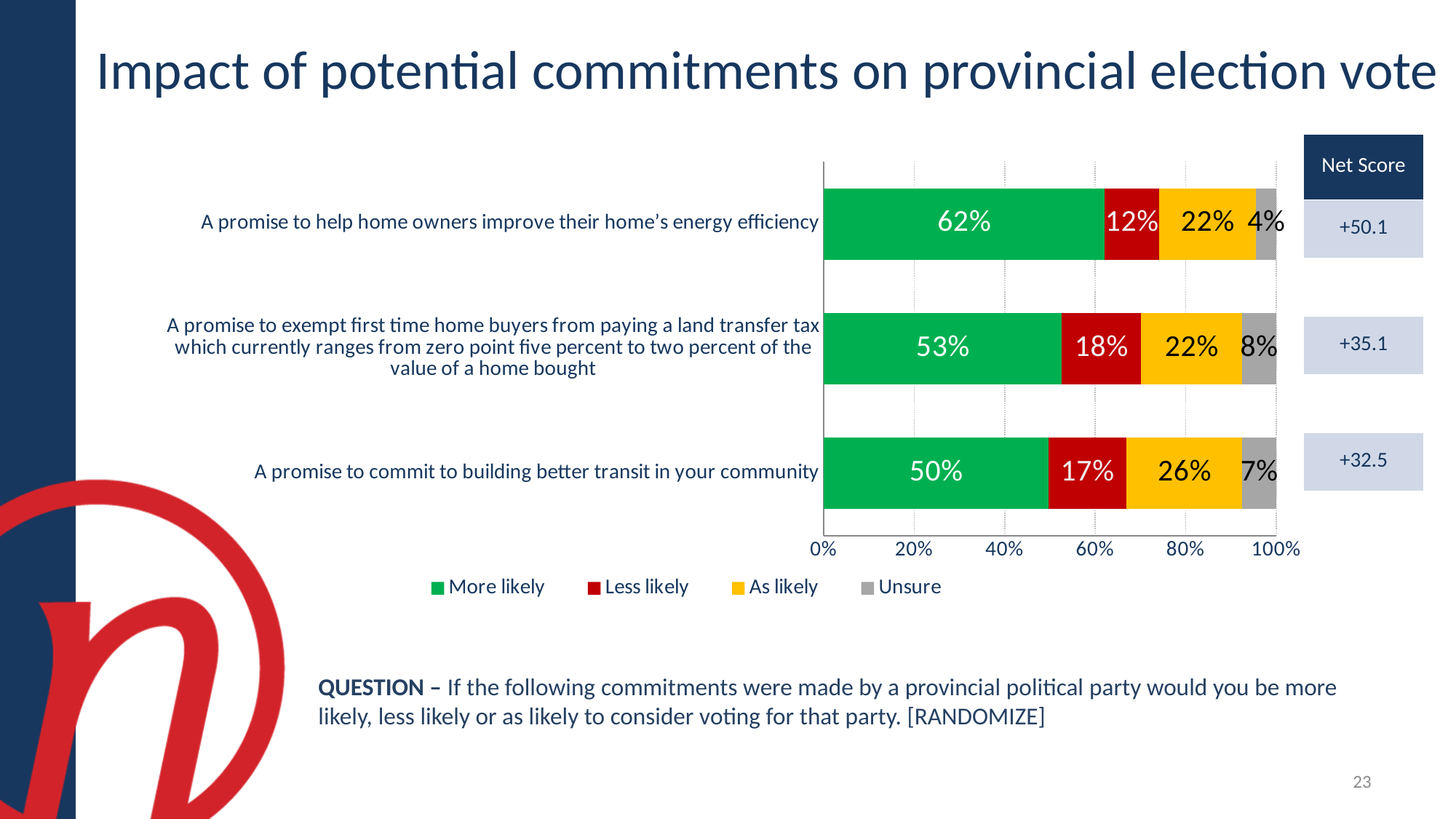
What percentage of respondents said they would be more likely to vote for a party that promised to help home owners improve their home's energy efficiency? 62% What is the 'Less likely' value for the promise to exempt first time home buyers from paying a land transfer tax? 18% What is the 'Unsure' value for the promise to help home owners improve their home's energy efficiency? 4% What is the 'As likely' value for the promise to commit to building better transit in your community? 26% Which commitment has the lowest 'Less likely' percentage? A promise to help home owners improve their home's energy efficiency What is the Net Score shown for the promise to commit to building better transit in your community? +32.5 What kind of chart is shown on the slide? Stacked bar chart How many series does the legend list? 4 Which commitment has the highest 'More likely' percentage? A promise to help home owners improve their home's energy efficiency How many commitments (categories) are shown in the chart? 3 Which is larger: the 'Unsure' value for the land transfer tax promise or the 'Unsure' value for the better transit promise? The land transfer tax promise (8%) What is the difference between the 'More likely' values for the energy efficiency promise and the better transit promise? 12%